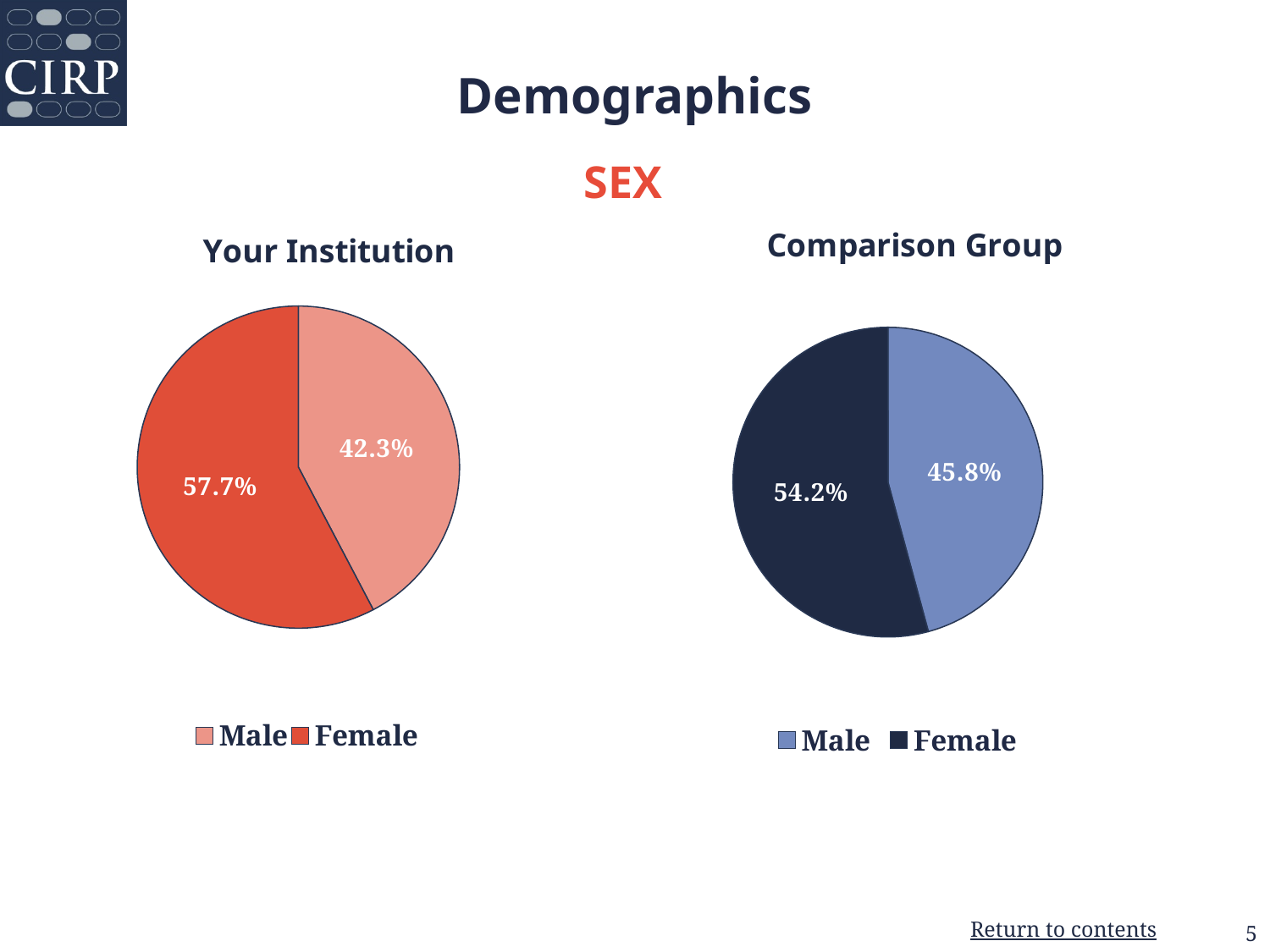
In the Your Institution chart, what percentage is Male? 42.3% In the Your Institution chart, which category has the largest share? Female In the Comparison Group chart, what is the difference between the Female and Male percentages? 8.4% How many slices does the Comparison Group pie chart have? 2 Is the Male share larger in the Your Institution chart or the Comparison Group chart? Comparison Group What two categories does the legend of the Your Institution chart list? Male and Female In the Comparison Group chart, what percentage is Male? 45.8% In the Comparison Group chart, what percentage is Female? 54.2% In the Your Institution chart, what is the difference between the Female and Male percentages? 15.4% In the Your Institution chart, what percentage is Female? 57.7% In the Comparison Group chart, which category has the smallest share? Male What type of chart is the Your Institution chart? Pie chart